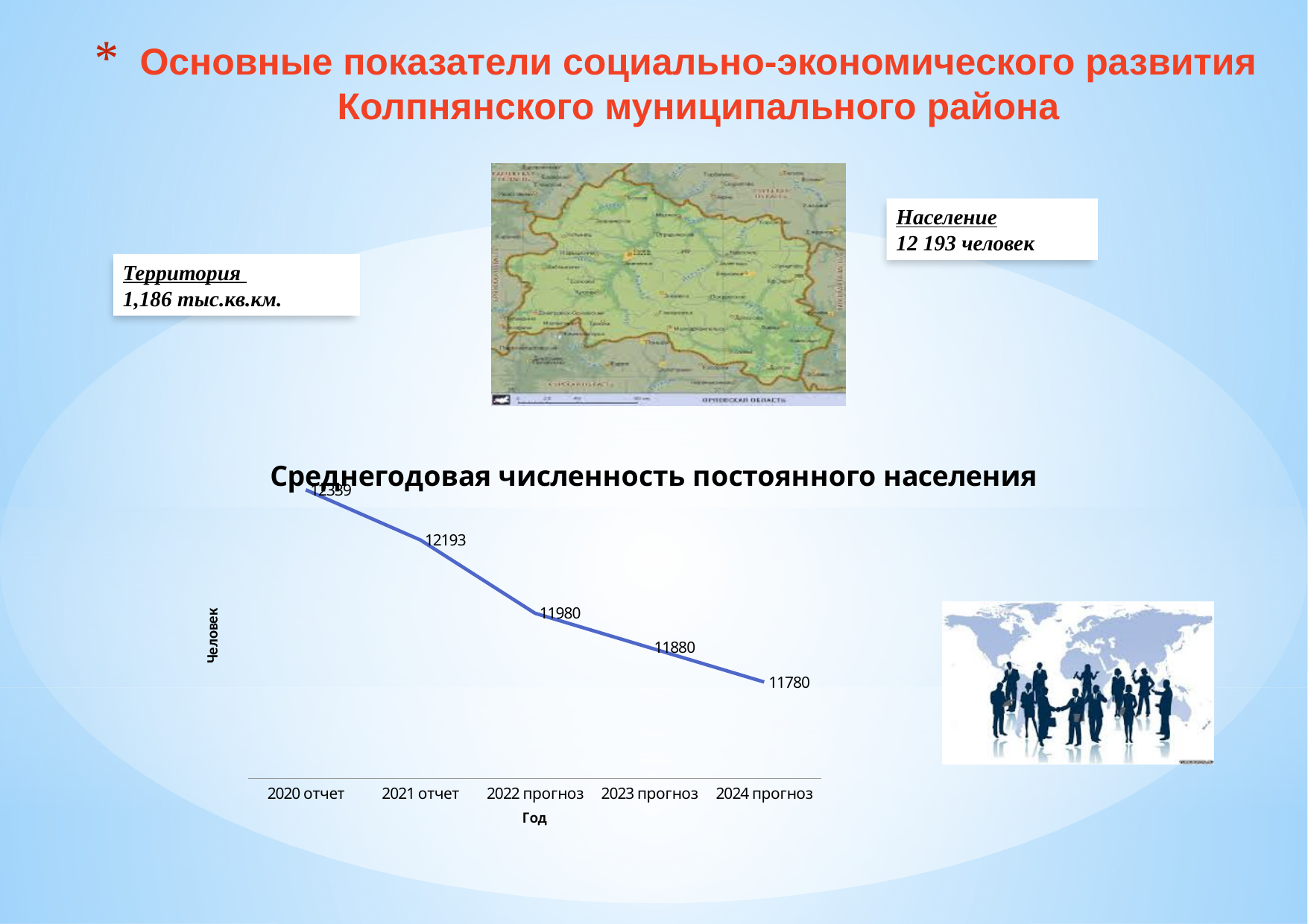
What is the value for '2021 отчет' in the chart 'Среднегодовая численность постоянного населения'? 12193 What is the value for '2022 прогноз' in the chart 'Среднегодовая численность постоянного населения'? 11980 What is the value for '2024 прогноз' in the chart 'Среднегодовая численность постоянного населения'? 11780 In the chart 'Среднегодовая численность постоянного населения', what is the difference between the values for '2021 отчет' and '2022 прогноз'? 213 In the chart 'Среднегодовая численность постоянного населения', which is larger: the value for '2022 прогноз' or for '2023 прогноз'? 2022 прогноз How many data points are plotted in the chart 'Среднегодовая численность постоянного населения'? 5 Which year has the lowest value in the chart 'Среднегодовая численность постоянного населения'? 2024 прогноз Do the values in the chart 'Среднегодовая численность постоянного населения' rise or fall from 2020 to 2024? fall What kind of chart is shown under the title 'Среднегодовая численность постоянного населения'? line chart Which year has the highest value in the chart 'Среднегодовая численность постоянного населения'? 2020 отчет In the chart 'Среднегодовая численность постоянного населения', what is the difference between the values for '2023 прогноз' and '2024 прогноз'? 100 What is the value for '2023 прогноз' in the chart 'Среднегодовая численность постоянного населения'? 11880